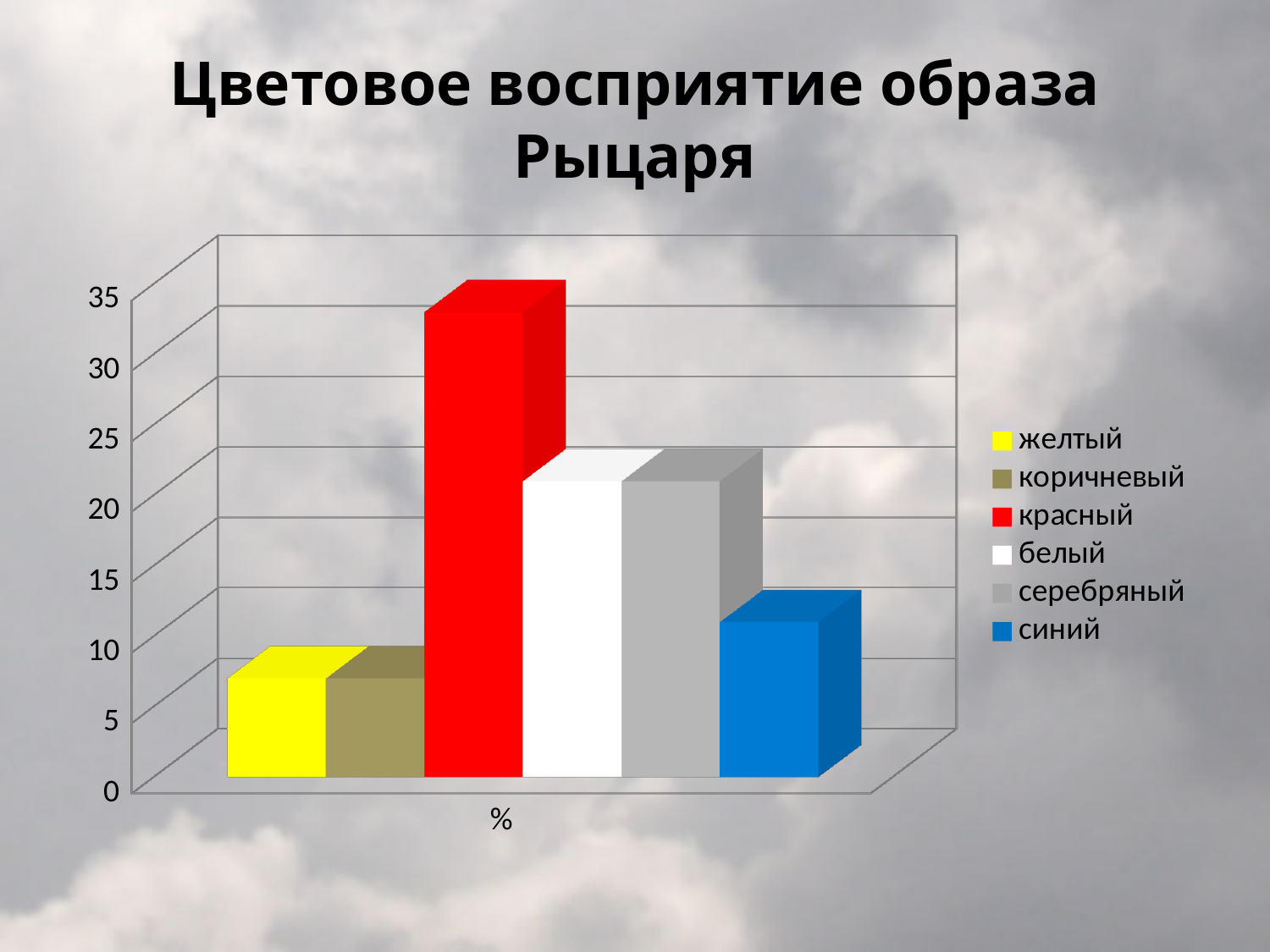
Is the value for желтый greater or less than 10? less How many bars are plotted in the chart? 6 What kind of chart is shown on the slide? bar chart Is the value for коричневый greater or less than 10? less How many series does the legend list? 6 Is the value for красный greater or less than 30? greater What is the title of the chart on the slide? Цветовое восприятие образа Рыцаря Which is larger, the value for белый or the value for желтый? белый Which colour has the highest value in the chart? красный Which is larger, the value for красный or the value for синий? красный